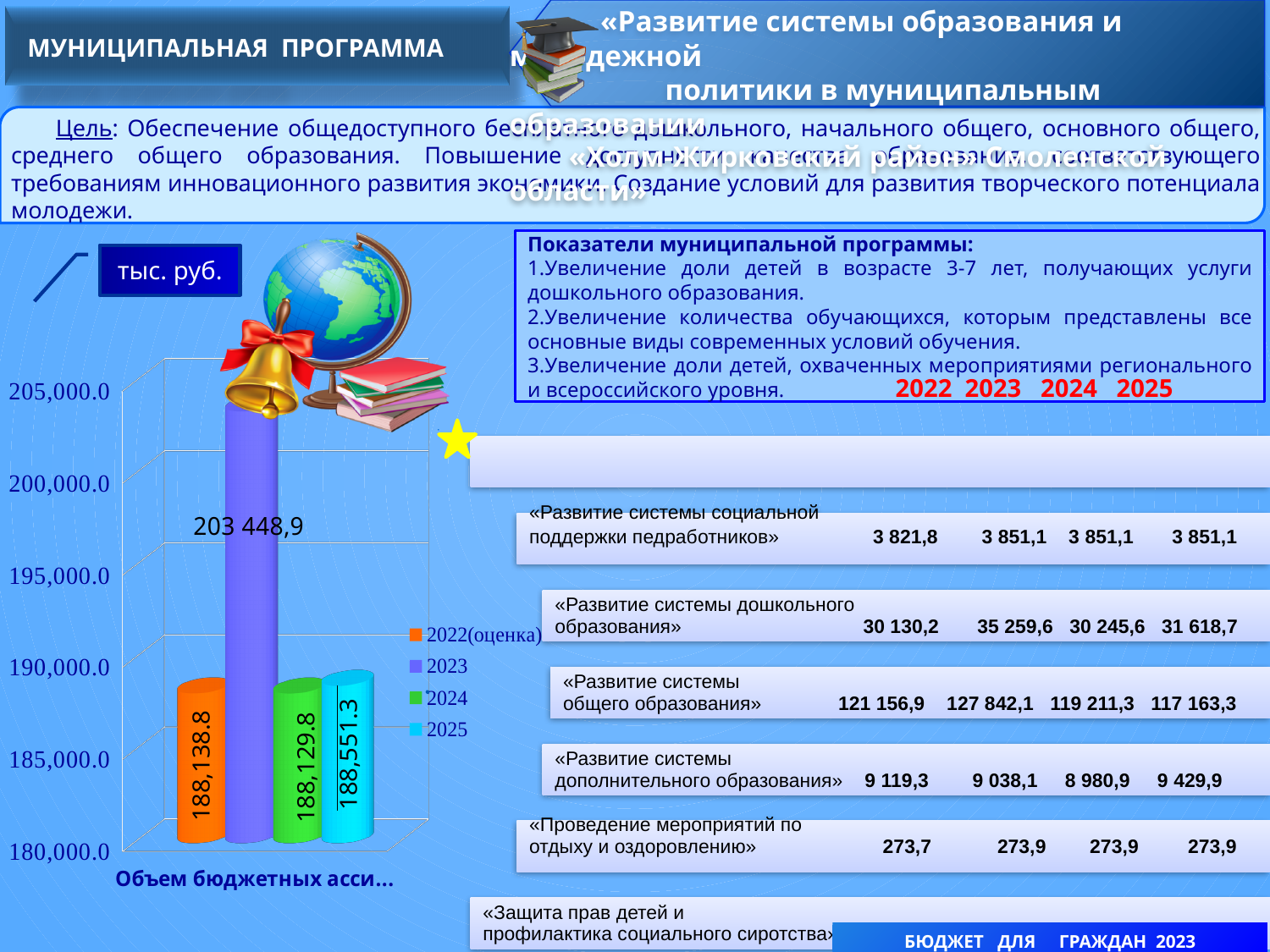
What is the value of the 2024 bar in the chart? 188,129.8 What is the value of the 2022(оценка) bar in the chart? 188,138.8 How many bars are plotted in the chart? 4 Is the value for 2023 in the chart greater or less than 200,000.0? greater What type of chart is shown on the slide? bar chart What is the value of the 2023 bar in the chart? 203 448,9 Which year has the highest bar in the chart? 2023 How many series does the chart legend list? 4 Which is larger in the chart, the value for 2025 or the value for 2022(оценка)? 2025 Which year has the lowest value in the chart? 2024 What unit is indicated in the box above the chart? тыс. руб. What is the value of the 2025 bar in the chart? 188,551.3